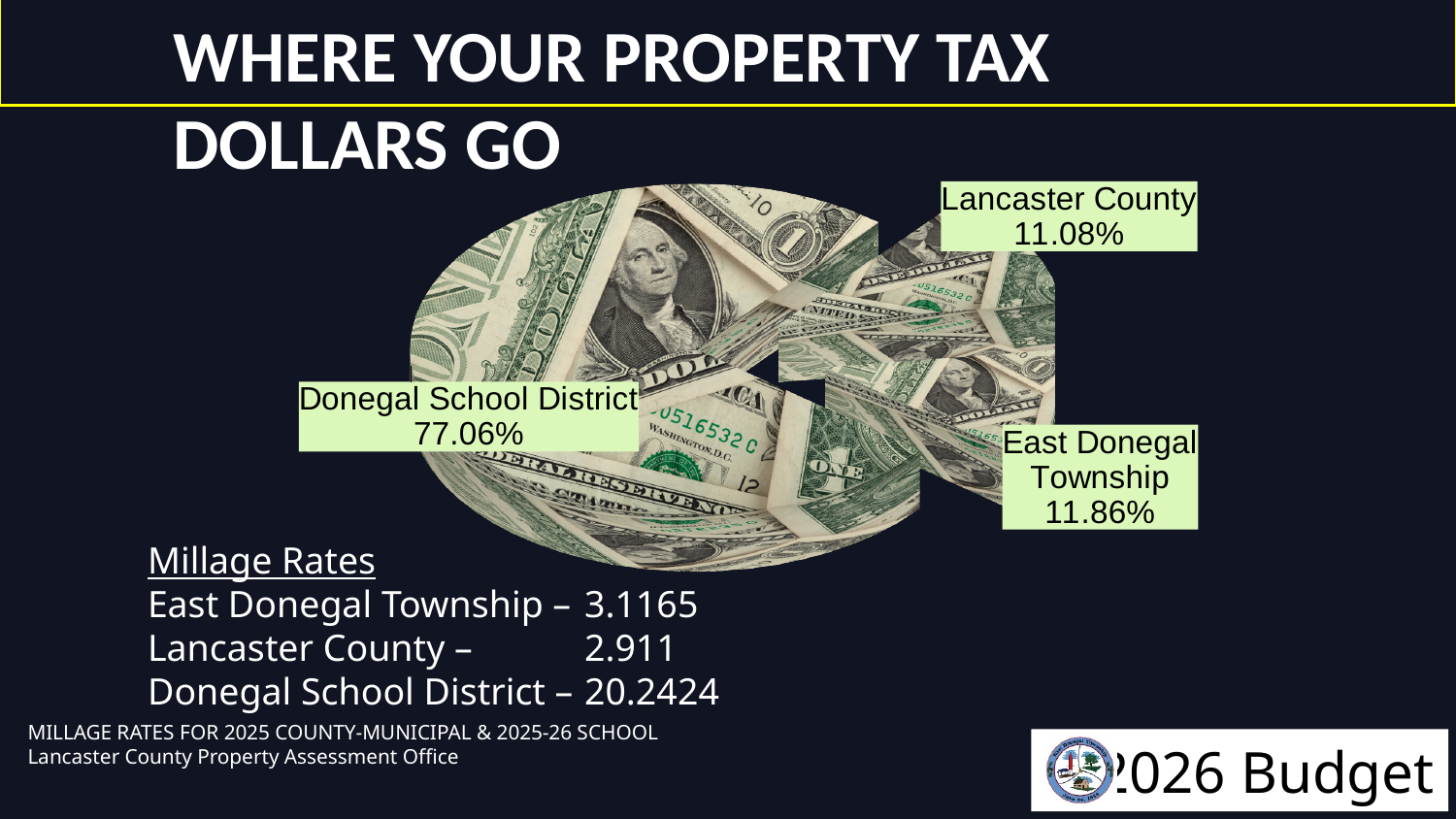
Which category receives the smallest share of property tax dollars? Lancaster County Which is larger, the share for East Donegal Township or the share for Lancaster County? East Donegal Township What is the title of the slide containing the chart? WHERE YOUR PROPERTY TAX DOLLARS GO Which category receives the largest share of property tax dollars? Donegal School District What share of property tax dollars goes to Lancaster County? 11.08% What is the difference between the Donegal School District share and the East Donegal Township share? 65.20% What is the difference between the East Donegal Township share and the Lancaster County share? 0.78% What share of property tax dollars goes to East Donegal Township? 11.86% What share of property tax dollars goes to Donegal School District? 77.06% How many slices does the pie chart have? 3 What image fills the slices of the pie chart? Dollar bills What kind of chart is shown on the slide? Pie chart